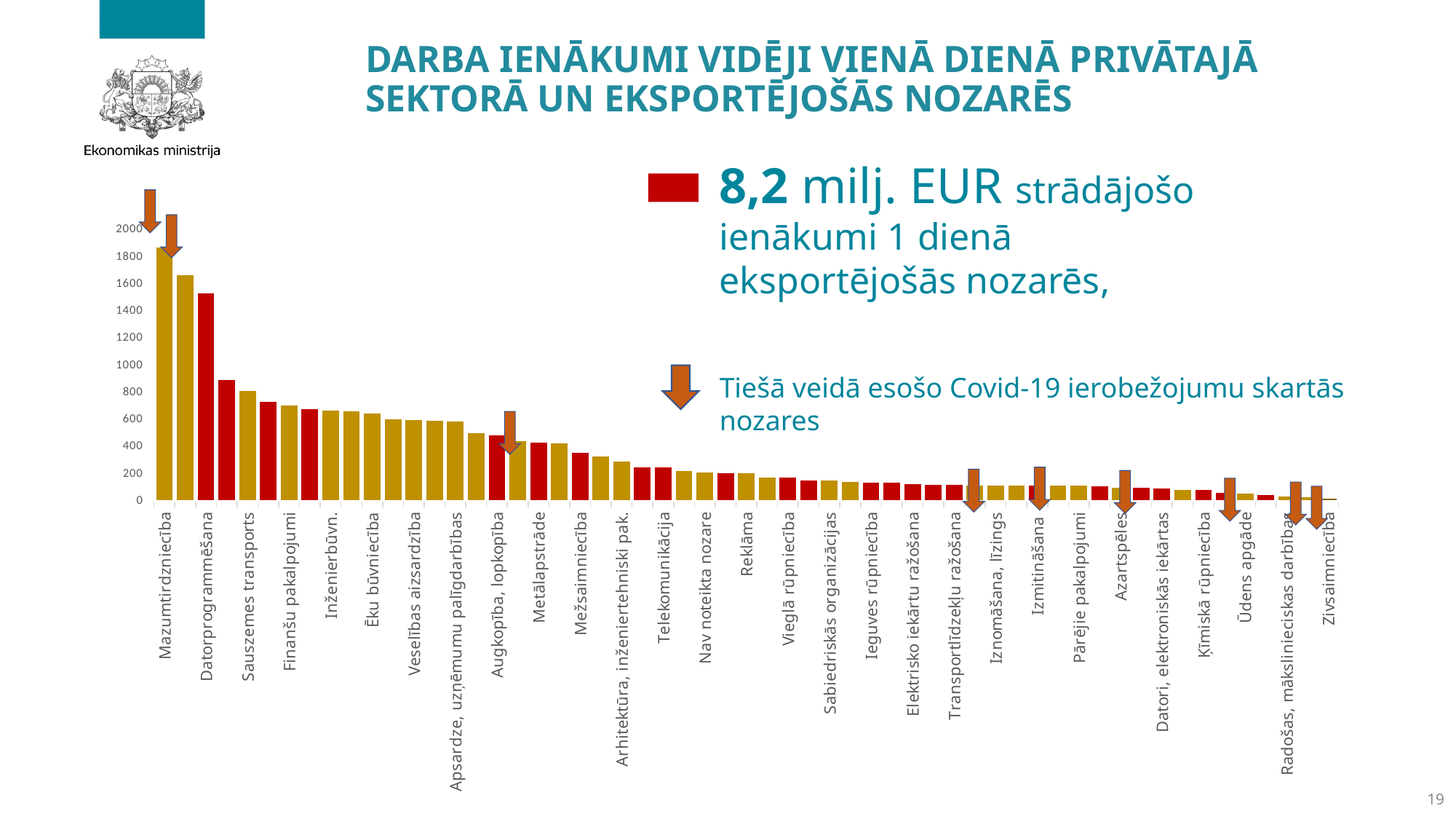
Is the value for Mazumtirdzniecība greater or less than 1600? greater What kind of chart is shown on the slide? bar chart Is the value for Datorprogrammēšana greater or less than 1400? greater Do the values rise or fall moving from left to right along the x axis? fall According to the slide, what do the red bars represent? eksportējošās nozares (exporting sectors) Is the value for Finanšu pakalpojumi greater or less than 800? less Which category has the lowest value in the chart? Zivsaimniecība Which category has the highest value in the chart? Mazumtirdzniecība Which has a larger value, Datorprogrammēšana or Sauszemes transports? Datorprogrammēšana